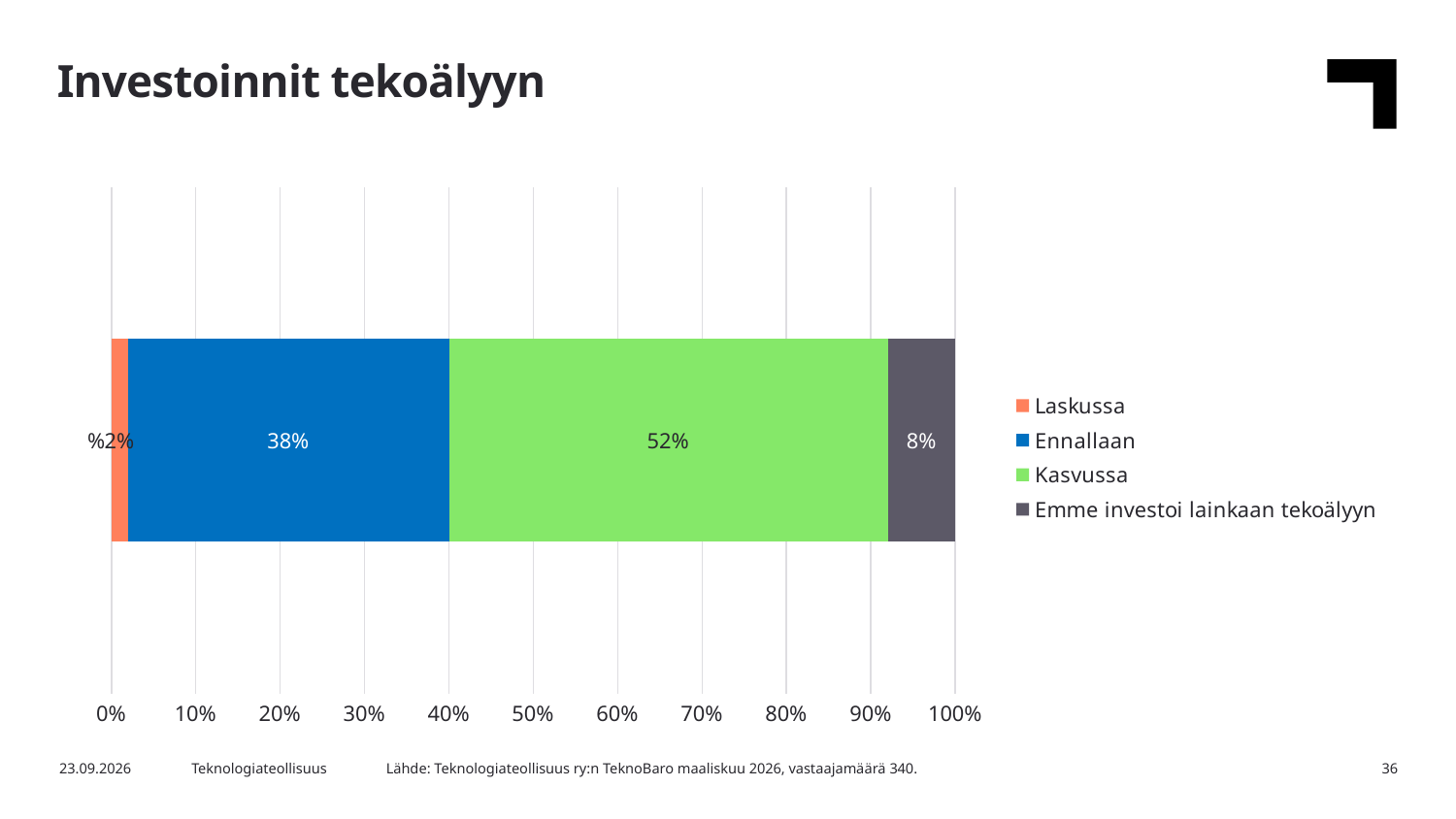
What is the value shown for "Laskussa"? 2% What is the total of all segments in the stacked bar? 100% What is the difference in percentage points between "Kasvussa" and "Ennallaan"? 14 What kind of chart is shown on the slide? Stacked bar chart Which category has the largest share in the bar? Kasvussa What is the value shown for "Ennallaan"? 38% What is the title of the chart on the slide? Investoinnit tekoälyyn Which is larger, the share for "Ennallaan" or the share for "Emme investoi lainkaan tekoälyyn"? Ennallaan How many series does the legend list? 4 What percentage of respondents reported investments in AI as "Kasvussa"? 52% Which category has the smallest share in the bar? Laskussa What share of respondents answered "Emme investoi lainkaan tekoälyyn"? 8%